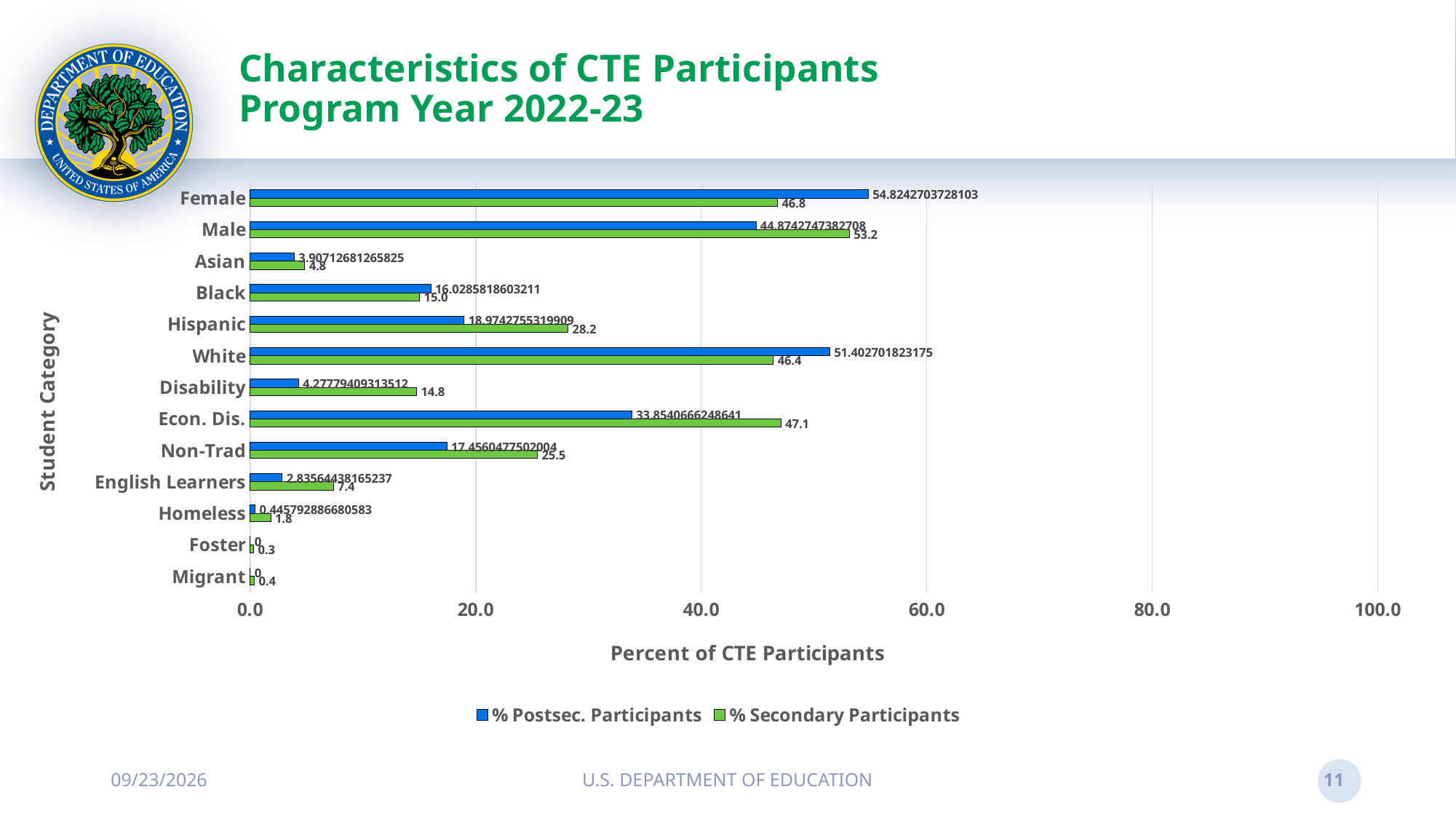
What is the title of the horizontal axis? Percent of CTE Participants Is the % Postsec. Participants value for Econ. Dis. greater or less than 40.0? less Which student category has the highest % Secondary Participants value? Male How many student categories are shown on the chart? 13 How many series does the legend list? 2 For Disability, which is larger: % Postsec. Participants or % Secondary Participants? % Secondary Participants What is the % Postsec. Participants value for White? 51.402701823175 Which student category has the lowest % Secondary Participants value? Foster What kind of chart is shown on the slide? bar chart What is the difference between the % Secondary Participants values for Hispanic and Black? 13.2 What is the % Secondary Participants value for Male? 53.2 What is the % Secondary Participants value for Econ. Dis.? 47.1